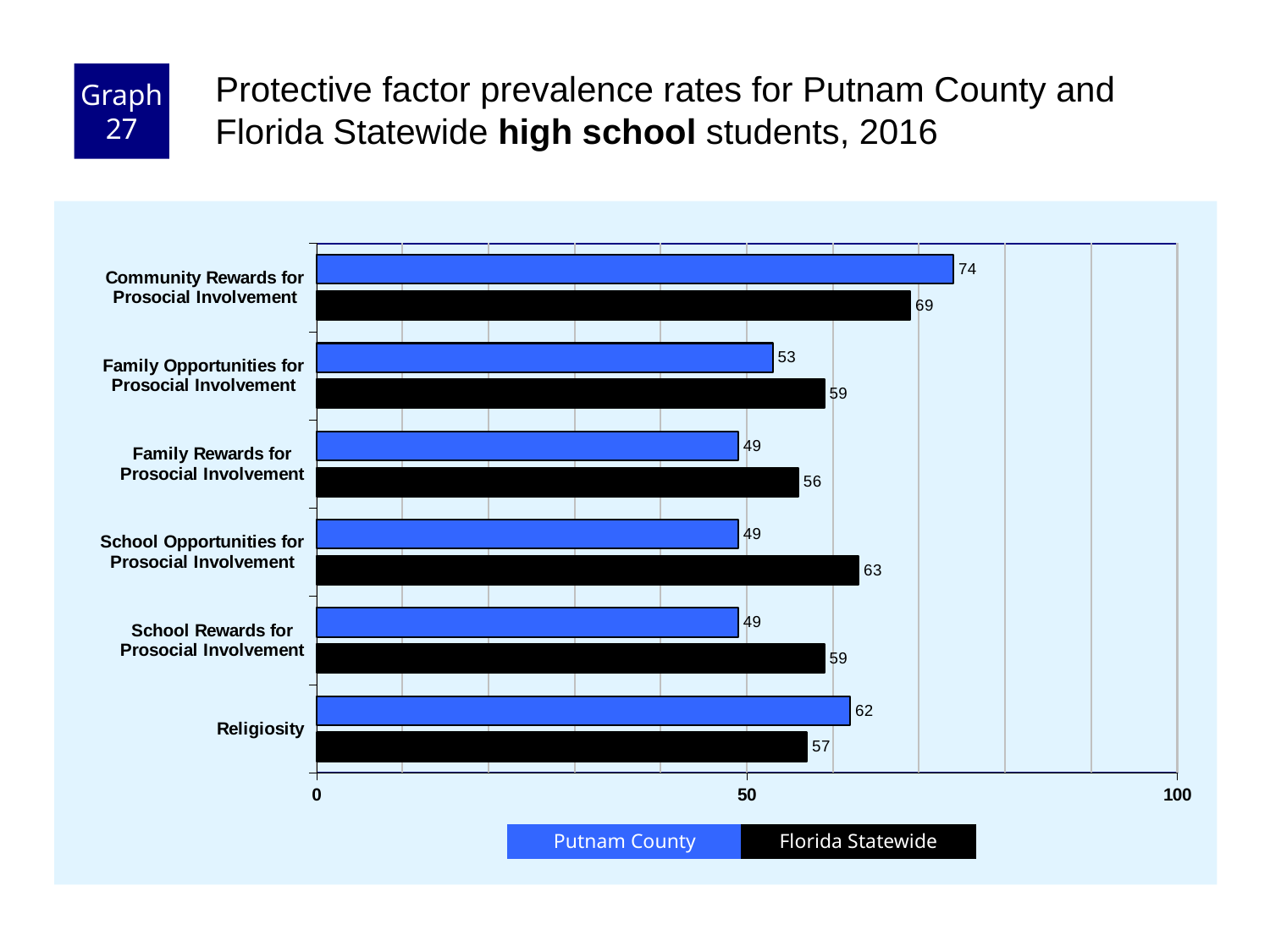
What is the difference between the Florida Statewide and Putnam County values for School Opportunities for Prosocial Involvement? 14 How many protective factors are shown on the chart? 6 How many series does the legend list? 2 Which colour represents Florida Statewide in the chart? black Which protective factor has the highest Putnam County value? Community Rewards for Prosocial Involvement What is the Florida Statewide value for School Opportunities for Prosocial Involvement? 63 Which protective factor has the lowest Florida Statewide value? Family Rewards for Prosocial Involvement Is the Putnam County value for Family Rewards for Prosocial Involvement greater or less than 50? less For Religiosity, which is larger: the Putnam County value or the Florida Statewide value? Putnam County What type of chart is shown on the slide? bar chart What is the Putnam County value for Community Rewards for Prosocial Involvement? 74 What is the Florida Statewide value for Religiosity? 57